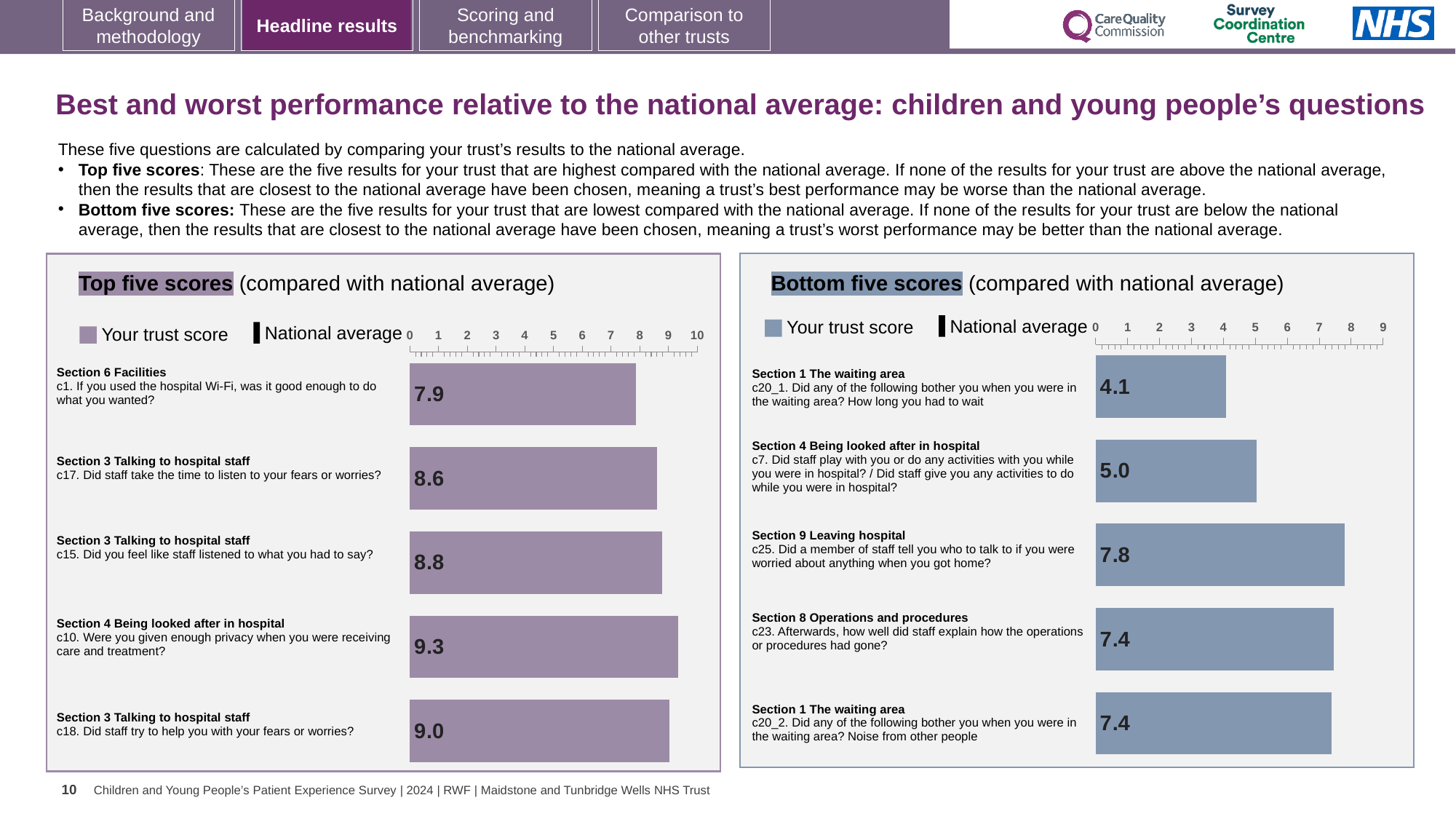
In the Top five scores chart, what is the trust score for c1 (hospital Wi-Fi good enough to do what you wanted)? 7.9 What type of chart is the Top five scores chart? Bar chart In the Top five scores chart, which question has the highest trust score? c10. Were you given enough privacy when you were receiving care and treatment? In the Top five scores chart, what is the difference between the trust scores for c10 (privacy) and c1 (hospital Wi-Fi)? 1.4 How many bars are plotted in the Top five scores chart? 5 In the Top five scores chart, is the trust score for c17 (did staff take the time to listen to your fears or worries) greater or less than 8? greater In the Bottom five scores chart, what is the trust score for c7 (did staff play with you or do any activities with you)? 5.0 In the Bottom five scores chart, what is the difference between the trust scores for c25 (who to talk to if worried at home) and c20_1 (how long you had to wait)? 3.7 In the Bottom five scores chart, which has the larger trust score: c25 (who to talk to if worried at home) or c23 (how well staff explained how operations had gone)? c25 How many entries does the legend of the Bottom five scores chart list? 2 In the Bottom five scores chart, what is the trust score for c20_2 (noise from other people in the waiting area)? 7.4 In the Bottom five scores chart, which question has the lowest trust score? c20_1. How long you had to wait